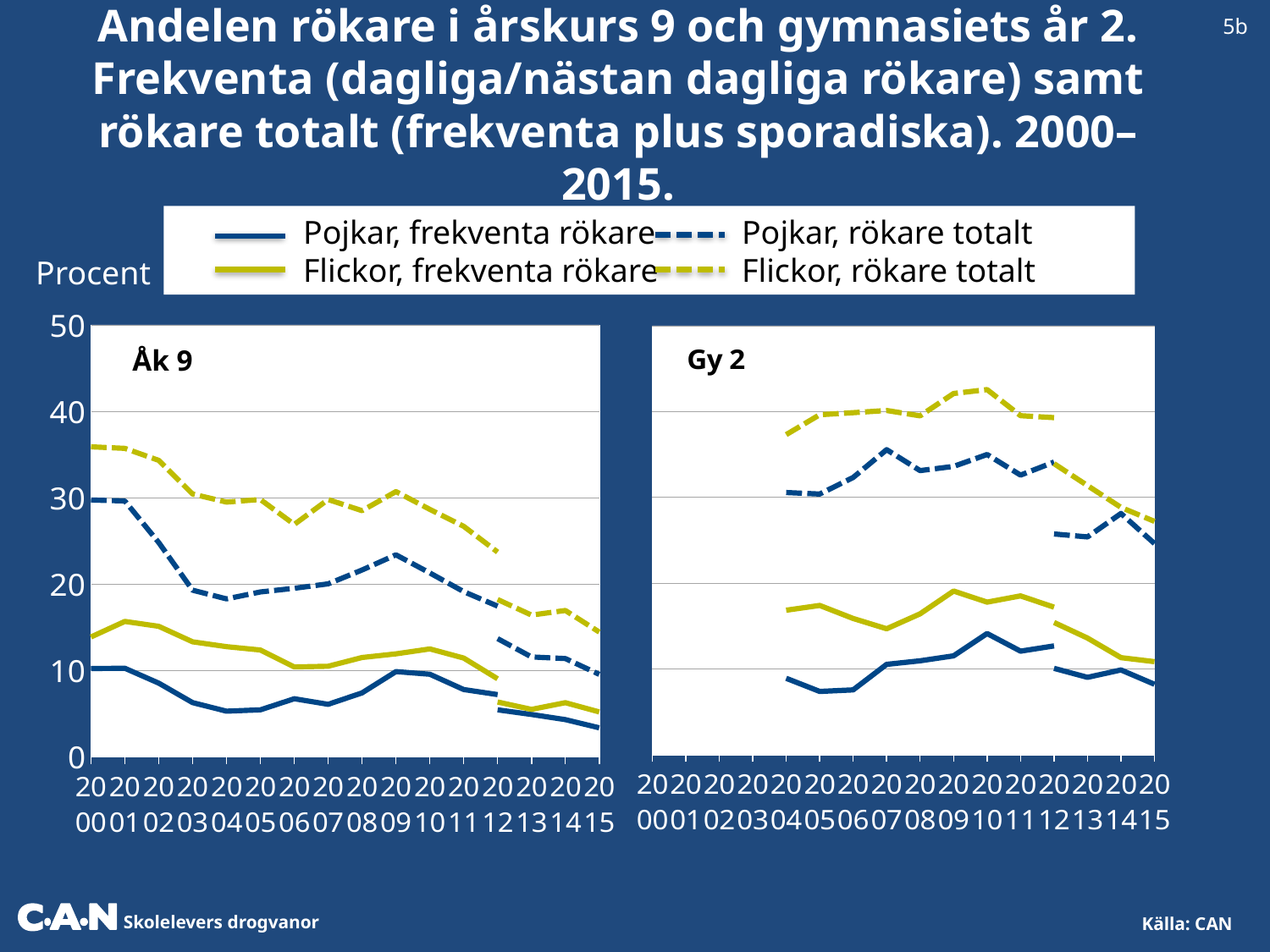
In the Åk 9 chart, is the value for Flickor, rökare totalt in 2000 greater or less than 30? greater In the Åk 9 chart, does Flickor, rökare totalt rise or fall from 2000 to 2015? fall In the Gy 2 chart, which series has the highest value in 2010? Flickor, rökare totalt How many series does the legend list? 4 In the Gy 2 chart, is the value for Pojkar, rökare totalt in 2007 greater or less than 30? greater In the Åk 9 chart, is the value for Pojkar, frekventa rökare in 2015 greater or less than 10? less In the Gy 2 chart, which series has the lowest value in 2015? Pojkar, frekventa rökare What type of chart is used for the Åk 9 panel? line chart What label is shown on the y axis of the charts? Procent In the Åk 9 chart, which is higher in 2000: Flickor, rökare totalt or Pojkar, rökare totalt? Flickor, rökare totalt